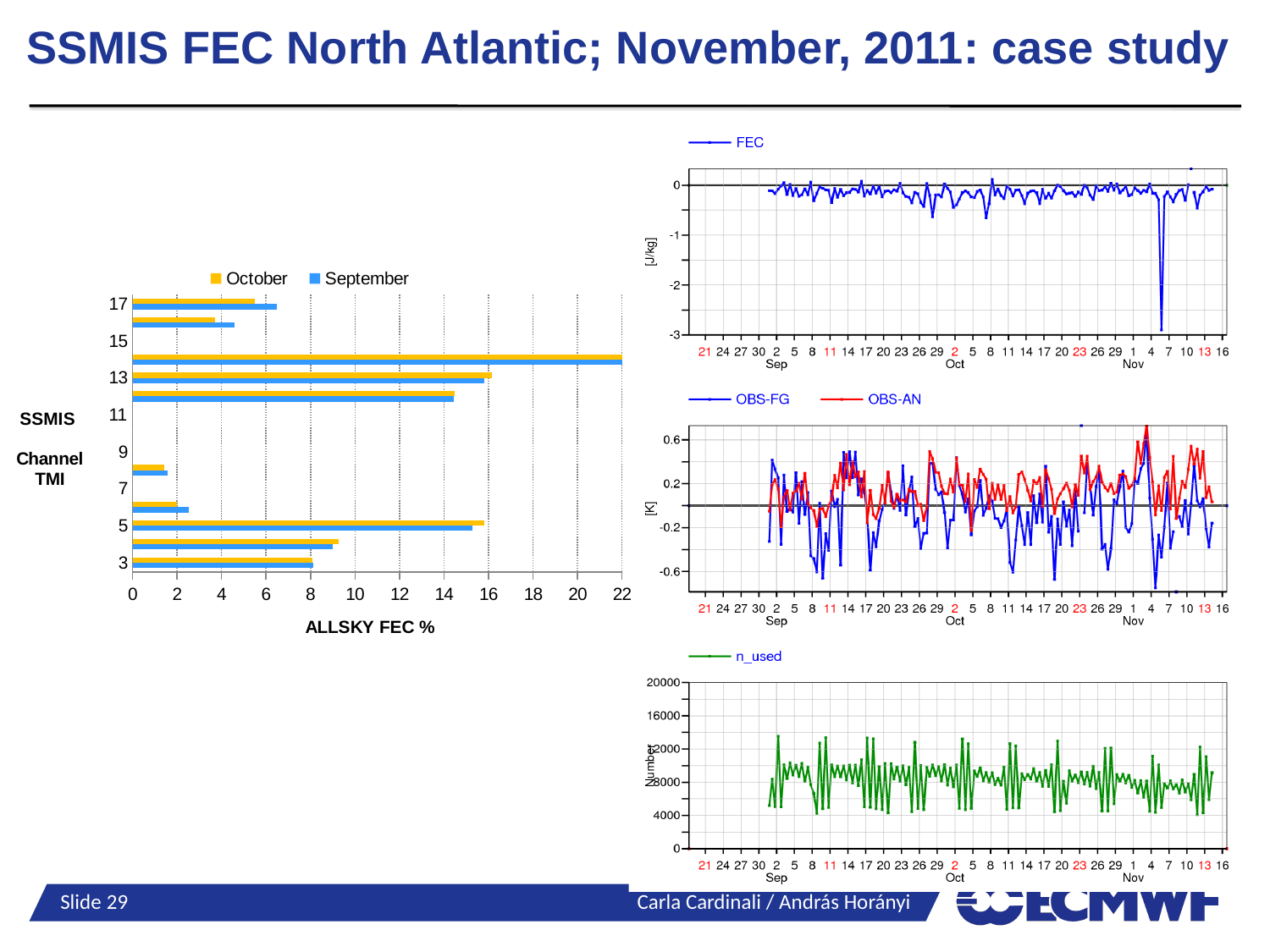
In the ALLSKY FEC % bar chart, is the October value for channel 13 greater or less than 14? greater How many series does the legend of the middle chart on the right (OBS-FG / OBS-AN) list? 2 In the FEC line chart at the top right, is the lowest value greater or less than -2? less What kind of chart is the ALLSKY FEC % chart on the left of the slide? bar chart In the ALLSKY FEC % bar chart, is the September value for channel 17 greater or less than 6? greater In the ALLSKY FEC % bar chart, which series has the larger value for channel 17, October or September? September In the ALLSKY FEC % bar chart, which colour represents September? blue Which two series are listed in the legend of the ALLSKY FEC % bar chart? October and September How many series does the legend of the ALLSKY FEC % bar chart list? 2